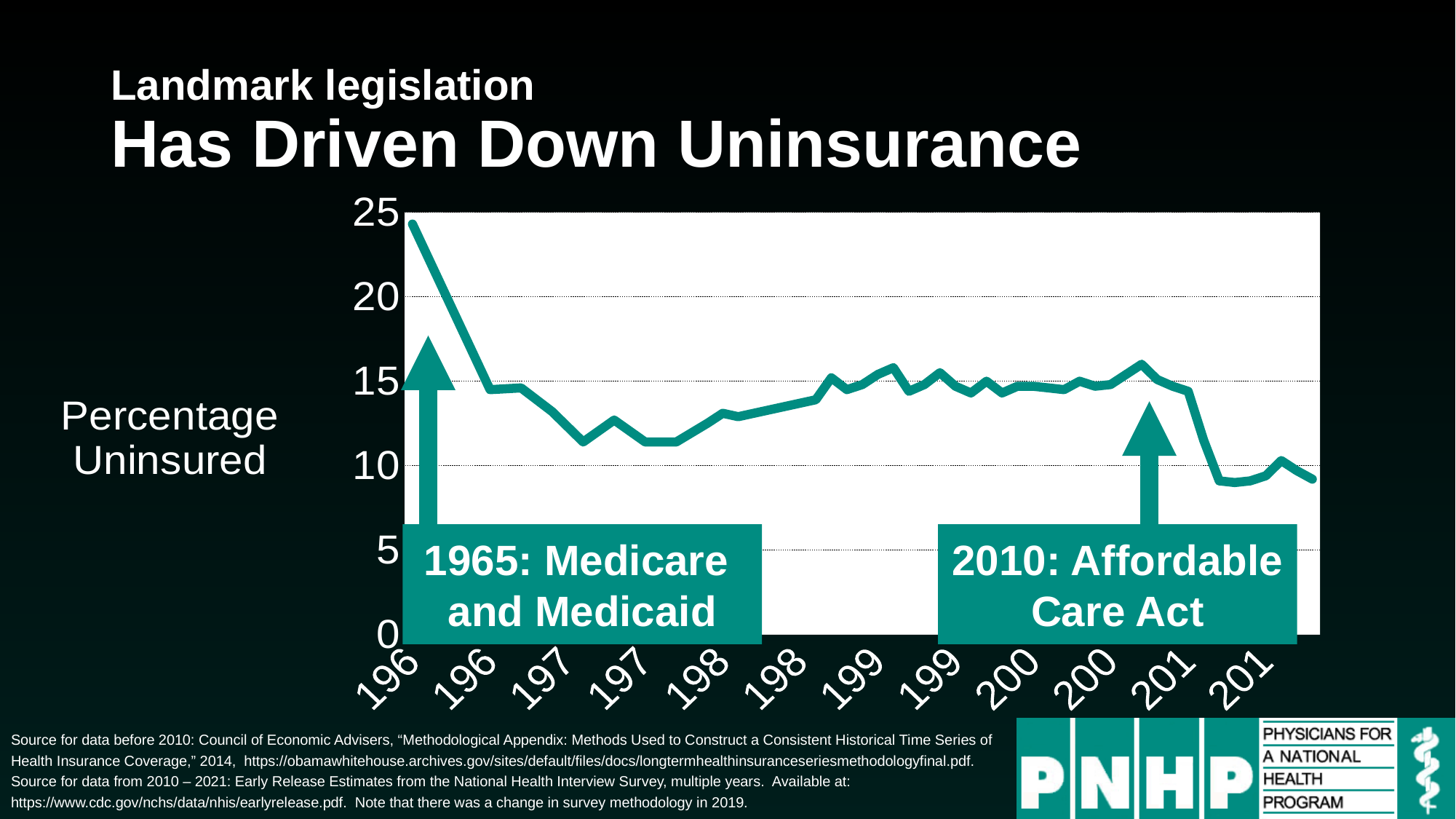
Overall, does the percentage uninsured rise or fall from the start of the series to the end? fall What kind of chart is shown on the slide? line chart Is the value at the last point of the line (around 2021) greater or less than 10? less Is the lowest value in the 1970s dip greater or less than 10? greater Is the highest point of the line at the beginning or at the end of the series? at the beginning Is the lowest value in the 1970s dip greater or less than 15? less What does the y axis of the chart measure? Percentage Uninsured What is the highest value shown on the y axis of the chart? 25 Which is larger: the value at the start of the series (around 1960) or the value at the end (around 2021)? the start (around 1960) Does the line rise or fall immediately after the 2010 Affordable Care Act marker? fall